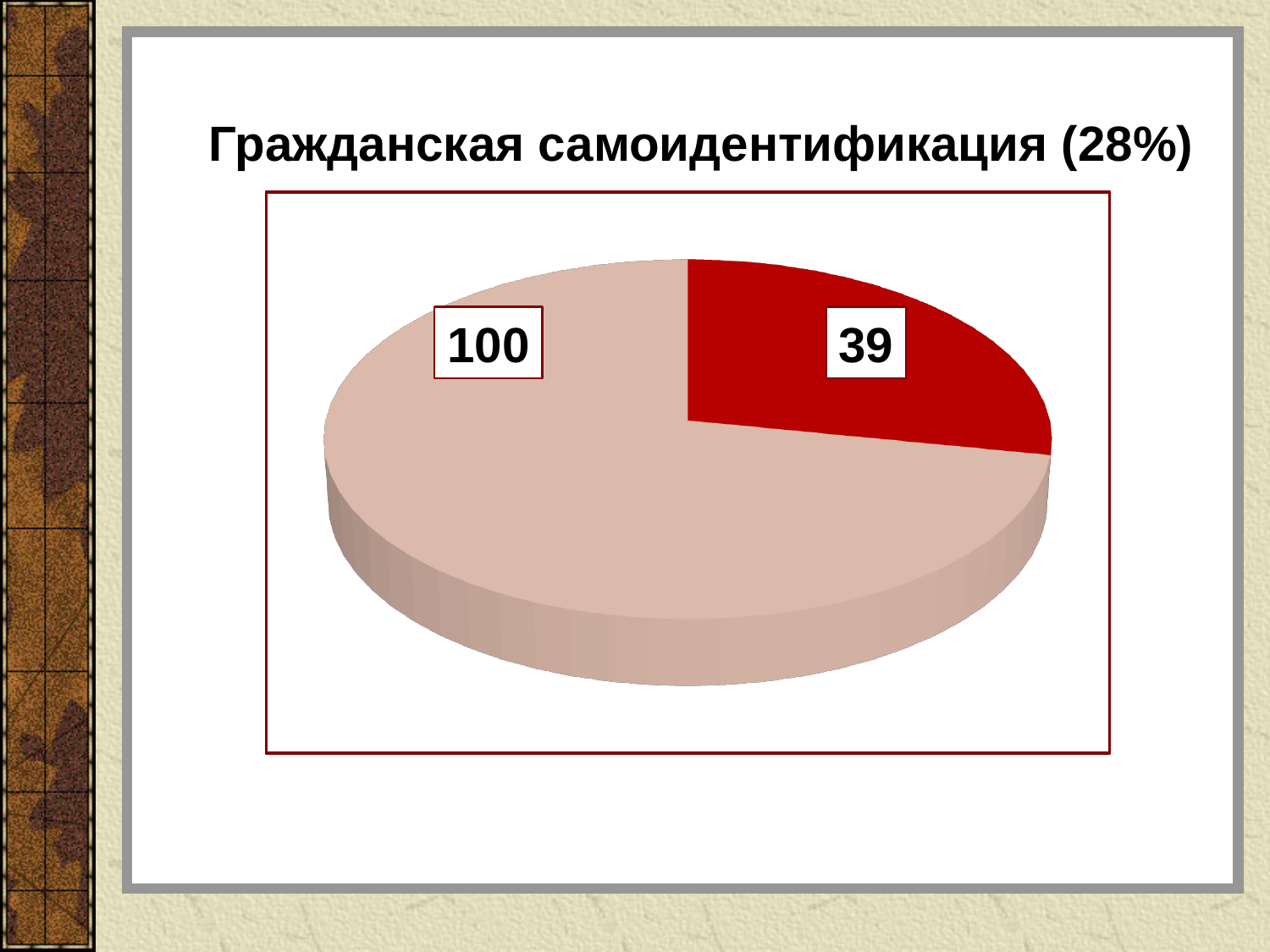
What value is labelled on the red slice of the pie chart? 39 What is the difference between the two slice values, 100 and 39? 61 What share of the pie does the red slice (39) represent? 28% What is the total of the two values shown in the pie chart? 139 Which slice has the smallest value in the pie chart? the red slice (39) What colour is the smaller slice of the pie chart? red Which is larger: the red slice or the pink slice? the pink slice How many slices does the pie chart have? 2 Which slice has the largest value in the pie chart? the pink slice (100) What value is labelled on the large pink slice of the pie chart? 100 What is the title of the chart on the slide? Гражданская самоидентификация (28%) What kind of chart is shown on the slide? pie chart